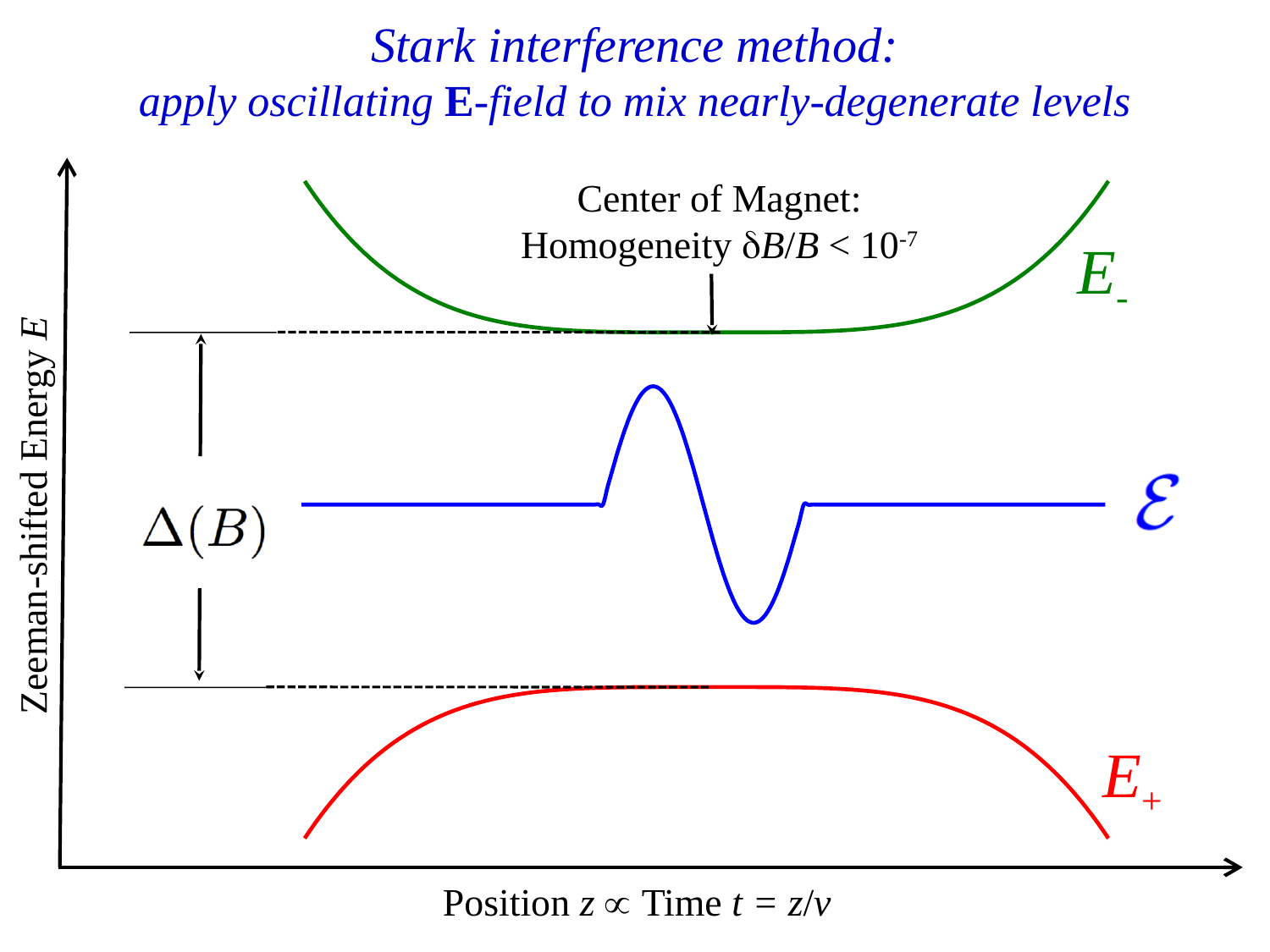
Which labelled curve sits lowest on the Zeeman-shifted Energy axis? E+ What is the label on the vertical axis? Zeeman-shifted Energy E What kind of chart is shown on the slide? line chart How many curves are plotted on the chart? 3 Which curve is higher in energy, E- or E+? E- Which labelled curve sits highest on the Zeeman-shifted Energy axis? E- Is the blue ℰ curve flat or oscillating at the left edge of the chart? flat What is the label on the horizontal axis? Position z ∝ Time t = z/v Does the E+ curve rise or fall as it approaches the right edge of the chart? fall Does the E- curve rise or fall as it approaches the right edge of the chart? rise